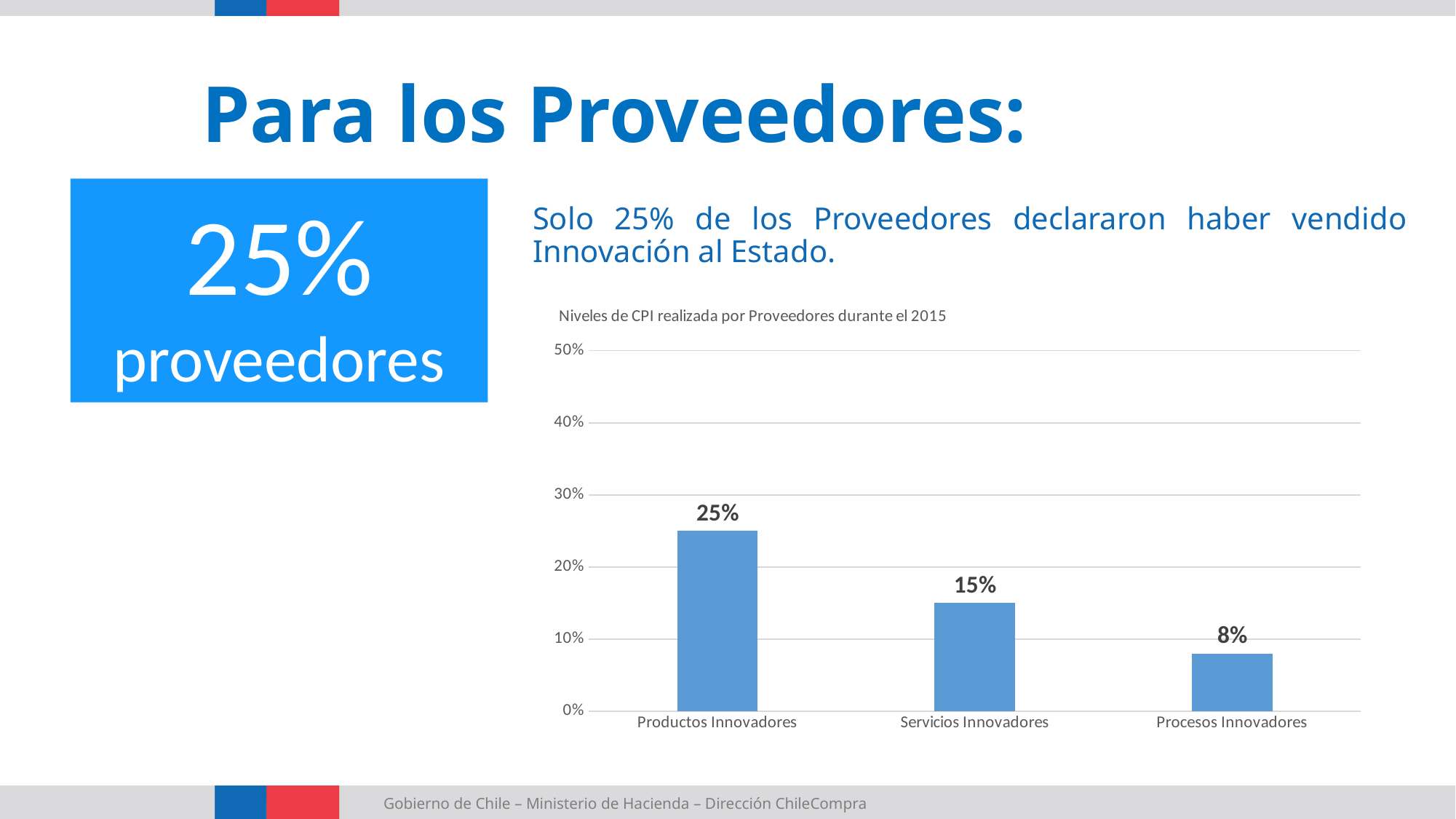
What is the difference between the values for Productos Innovadores and Servicios Innovadores? 10% What is the value for Productos Innovadores? 25% What is the value for Procesos Innovadores? 8% What kind of chart is shown on the slide? Bar chart Is the value for Productos Innovadores greater or less than 20%? greater Which is larger, the value for Servicios Innovadores or Procesos Innovadores? Servicios Innovadores What is the difference between the values for Servicios Innovadores and Procesos Innovadores? 7% How many categories are shown on the chart? 3 What is the value for Servicios Innovadores? 15% What is the title of the chart? Niveles de CPI realizada por Proveedores durante el 2015 Which category has the highest value? Productos Innovadores Which category has the lowest value? Procesos Innovadores